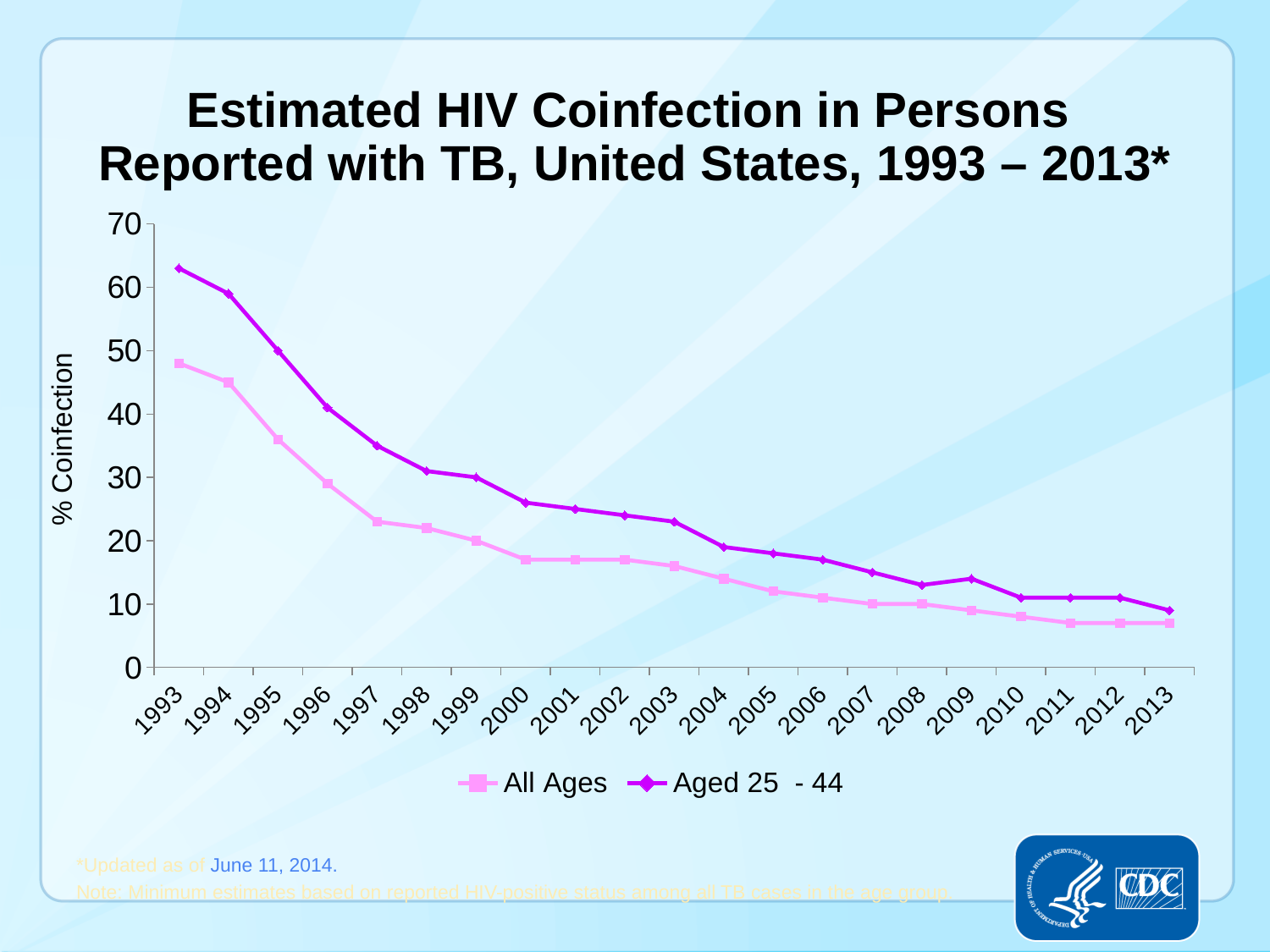
How many series does the legend list? 2 Is the value for All Ages in 1993 greater or less than 50? less Do the values for All Ages generally rise or fall from 1993 to 2013? fall Is the value for All Ages in 2013 greater or less than 10? less Which year has the highest value for the Aged 25 - 44 series? 1993 Which series has the higher value in 2000, All Ages or Aged 25 - 44? Aged 25 - 44 What is the label on the y axis? % Coinfection What kind of chart is shown on the slide? line chart Is the value for Aged 25 - 44 in 1993 greater or less than 60? greater How many years are plotted along the x axis? 21